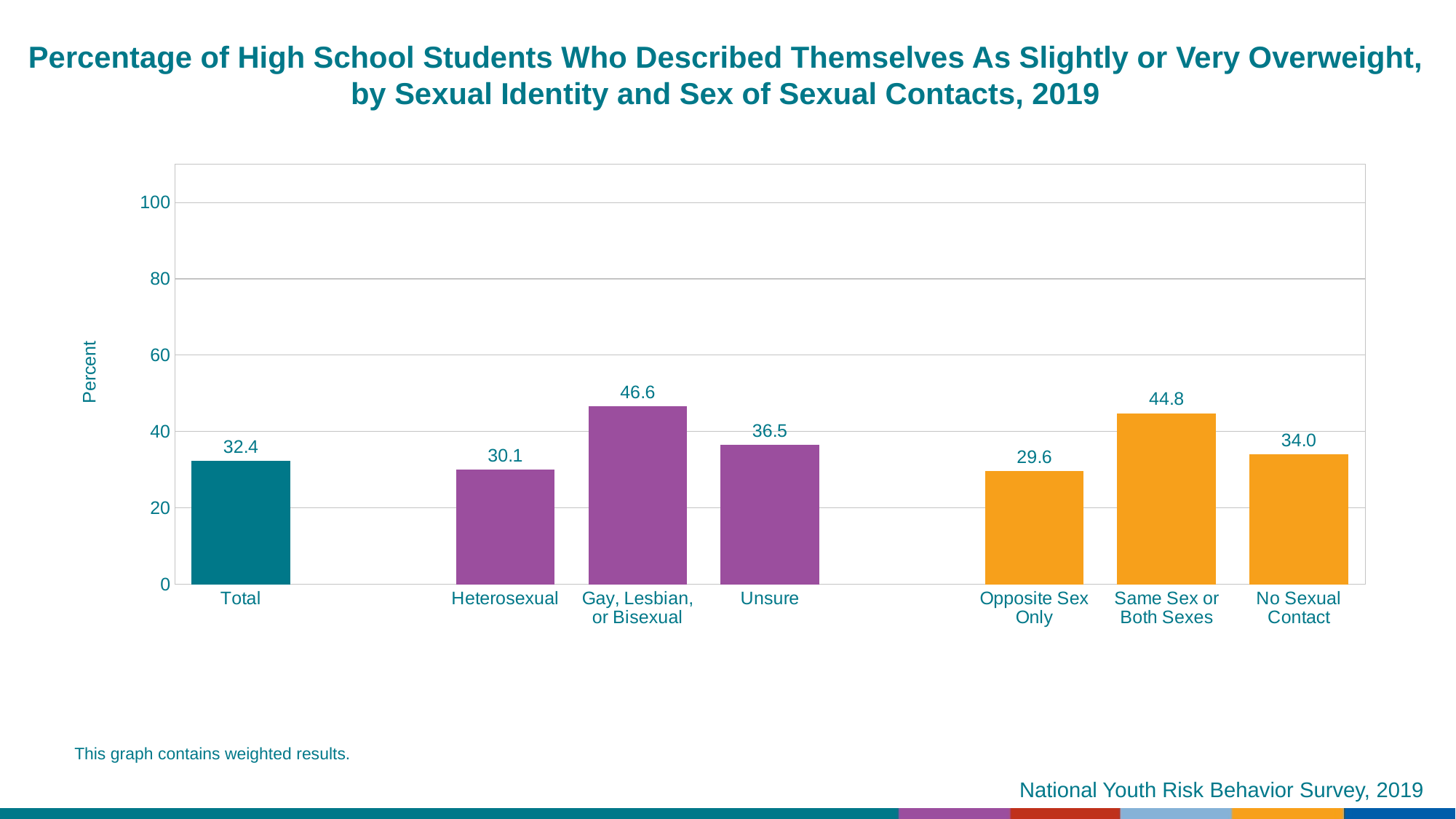
What is the value for Gay, Lesbian, or Bisexual students? 46.6 What is the difference between the values for Same Sex or Both Sexes and Opposite Sex Only? 15.2 Which is larger, the value for Unsure or the value for Heterosexual? Unsure What is the value for Opposite Sex Only? 29.6 What is the value for Total? 32.4 How many bars are shown in the chart? 7 What is the difference between the values for Gay, Lesbian, or Bisexual and Heterosexual? 16.5 Is the value for Same Sex or Both Sexes greater or less than 40? greater What kind of chart is shown on the slide? Bar chart Which category has the lowest value? Opposite Sex Only What is the value for No Sexual Contact? 34.0 Which category has the highest value? Gay, Lesbian, or Bisexual